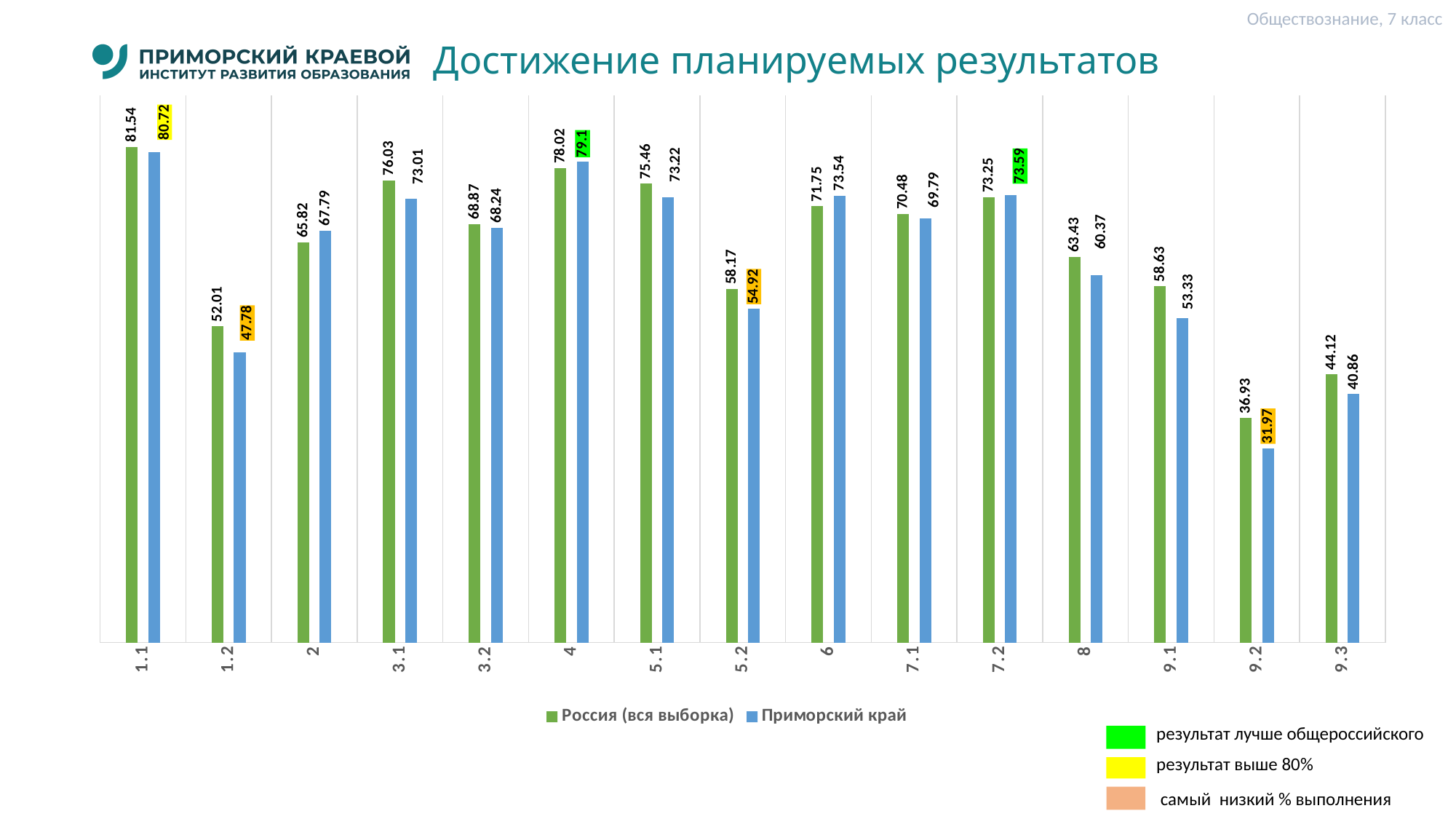
How many series does the chart legend list? 2 What is the value for Россия (вся выборка) for category 9.2? 36.93 How many categories are shown on the x axis of the chart? 15 Which category has the lowest value for Приморский край? 9.2 What is the difference between the Россия (вся выборка) and Приморский край values for category 1.2? 4.23 For category 4, which series has the larger value: Россия (вся выборка) or Приморский край? Приморский край What is the value for Приморский край for category 1.1? 80.72 What is the title of the chart on the slide? Достижение планируемых результатов What is the value for Приморский край for category 5.2? 54.92 What type of chart is shown on the slide? Bar chart Which category has the highest value for Россия (вся выборка)? 1.1 For category 9.1, which series has the larger value: Россия (вся выборка) or Приморский край? Россия (вся выборка)